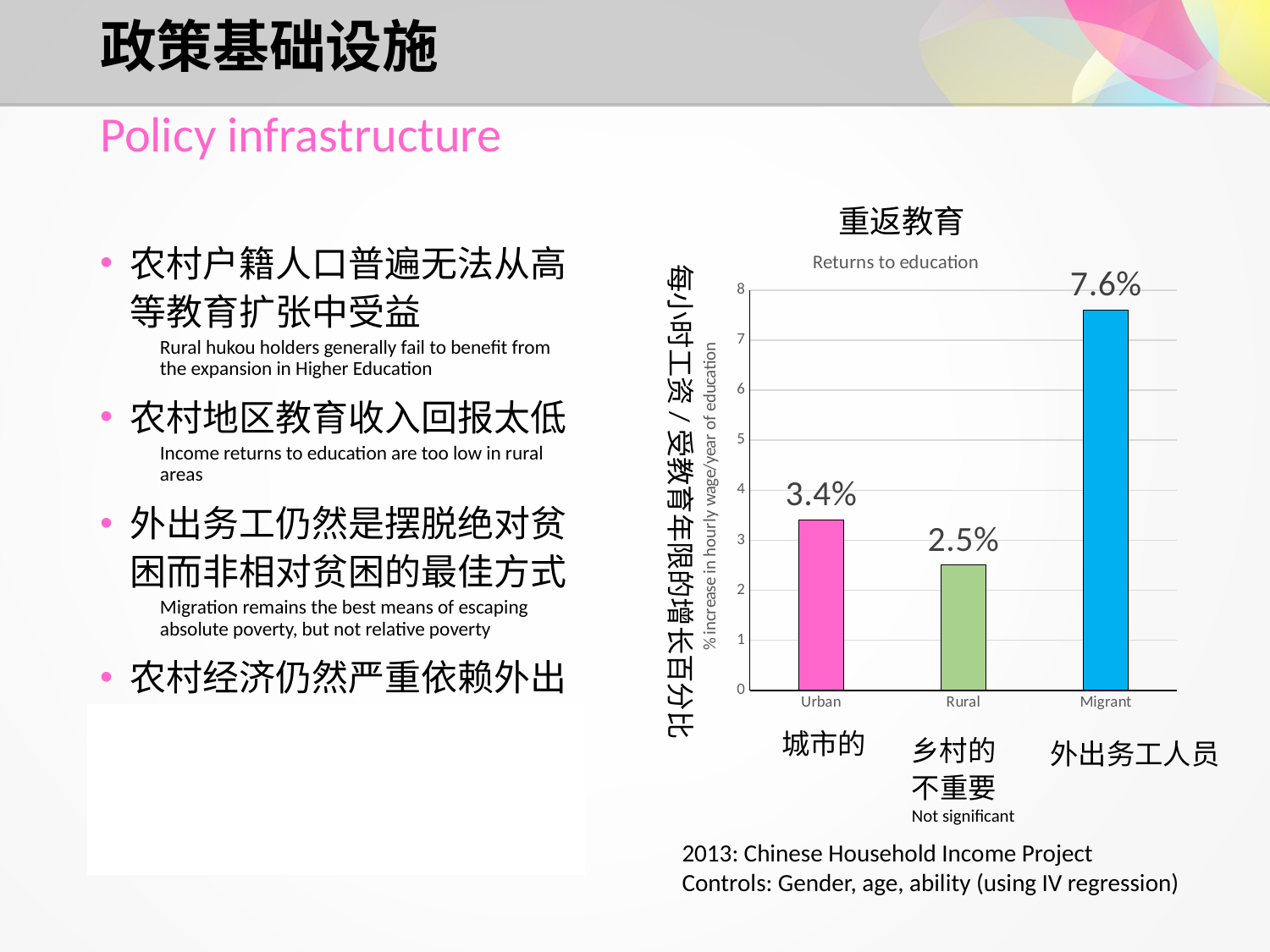
How many categories are shown in the Returns to education chart? 3 What is the difference between the Urban and Rural values in the Returns to education chart? 0.9% What is the value for Rural in the Returns to education chart? 2.5% Is the value for Migrant in the Returns to education chart greater or less than 7? greater What is the difference between the Migrant and Urban values in the Returns to education chart? 4.2% What colour is the Migrant bar in the Returns to education chart? blue Which is larger in the Returns to education chart, the value for Urban or the value for Rural? Urban What is the value for Migrant in the Returns to education chart? 7.6% What kind of chart is the Returns to education chart? bar chart What is the value for Urban in the Returns to education chart? 3.4% Which category has the lowest value in the Returns to education chart? Rural Which category has the highest value in the Returns to education chart? Migrant